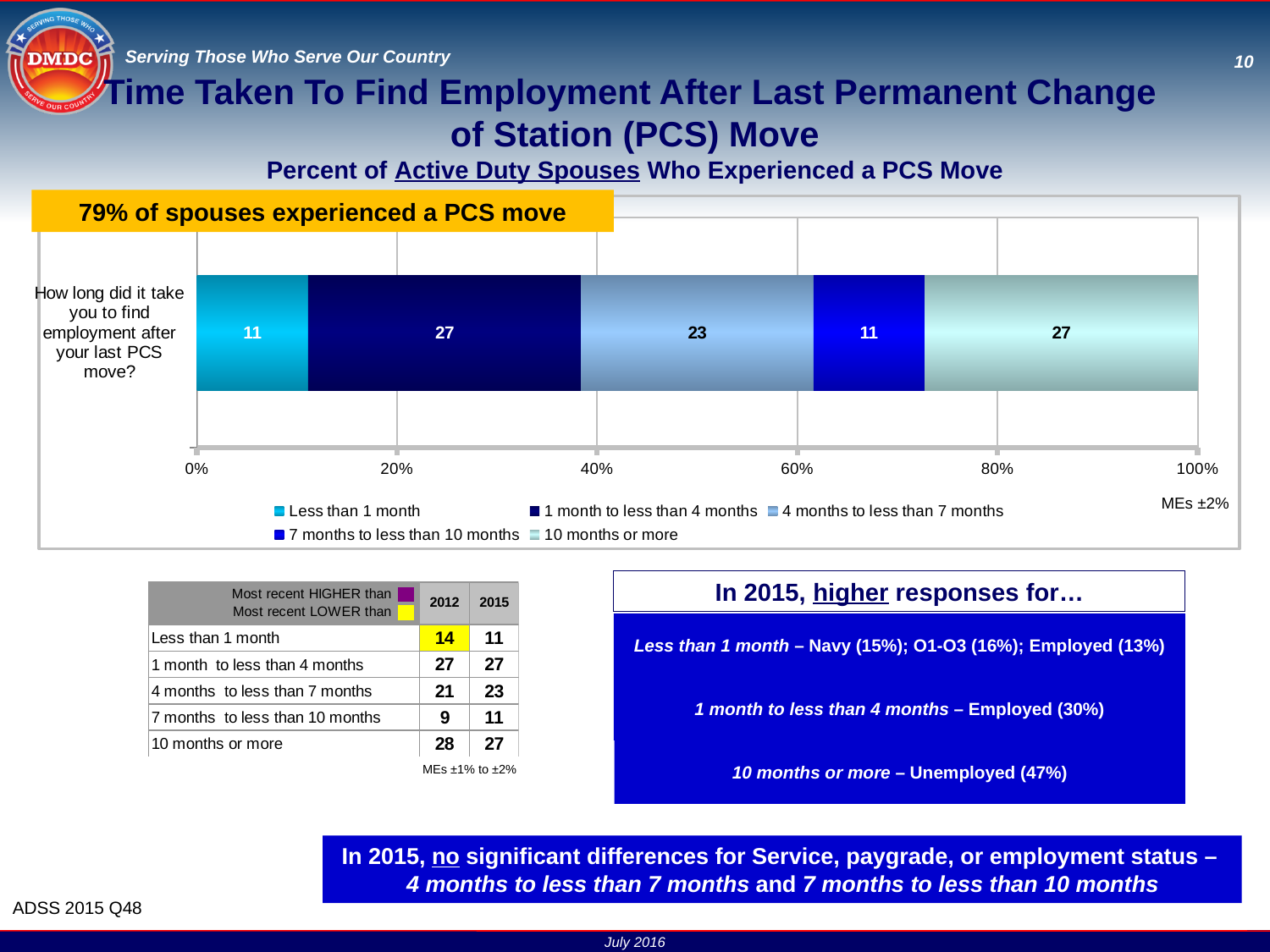
What is the value for the "Less than 1 month" segment of the bar? 11 What is the value for the "7 months to less than 10 months" segment of the bar? 11 What margin of error is noted next to the chart? MEs ±2% Which is larger, the "4 months to less than 7 months" value or the "7 months to less than 10 months" value? 4 months to less than 7 months What is the value for the "10 months or more" segment of the bar? 27 What is the difference between the "1 month to less than 4 months" value and the "4 months to less than 7 months" value? 4 What kind of chart is shown on the slide? Stacked bar chart What is the value for the "1 month to less than 4 months" segment of the bar? 27 How many series does the chart legend list? 5 What is the total of all segments in the stacked bar? 99 What is the highest value shown on the x axis of the chart? 100% What is the value for the "4 months to less than 7 months" segment of the bar? 23